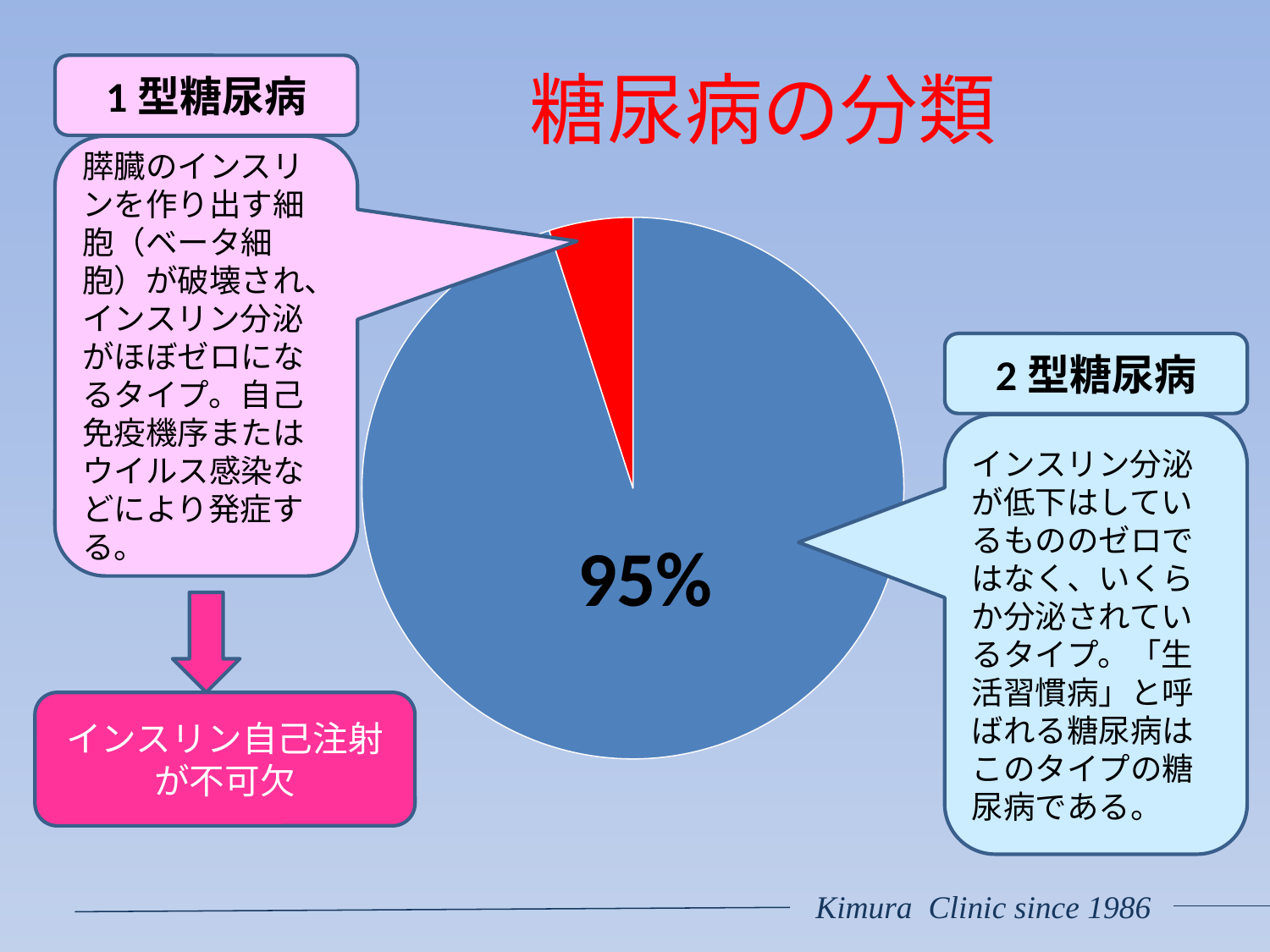
What percentage is printed on the large blue slice of the pie chart? 95% What is the title of the slide containing the pie chart? 糖尿病の分類 What share of the pie does 2型糖尿病 (the blue slice) represent? 95% What colour is the slice representing 1型糖尿病? red What kind of chart is shown on the slide? pie chart Which type of diabetes has the largest slice in the pie chart? 2型糖尿病 How many slices does the pie chart have? 2 Is the share for 1型糖尿病 greater or less than 10%? less Is the share for 2型糖尿病 greater or less than 90%? greater Which type of diabetes has the smallest slice in the pie chart? 1型糖尿病 Which slice is larger, the red slice or the blue slice? the blue slice